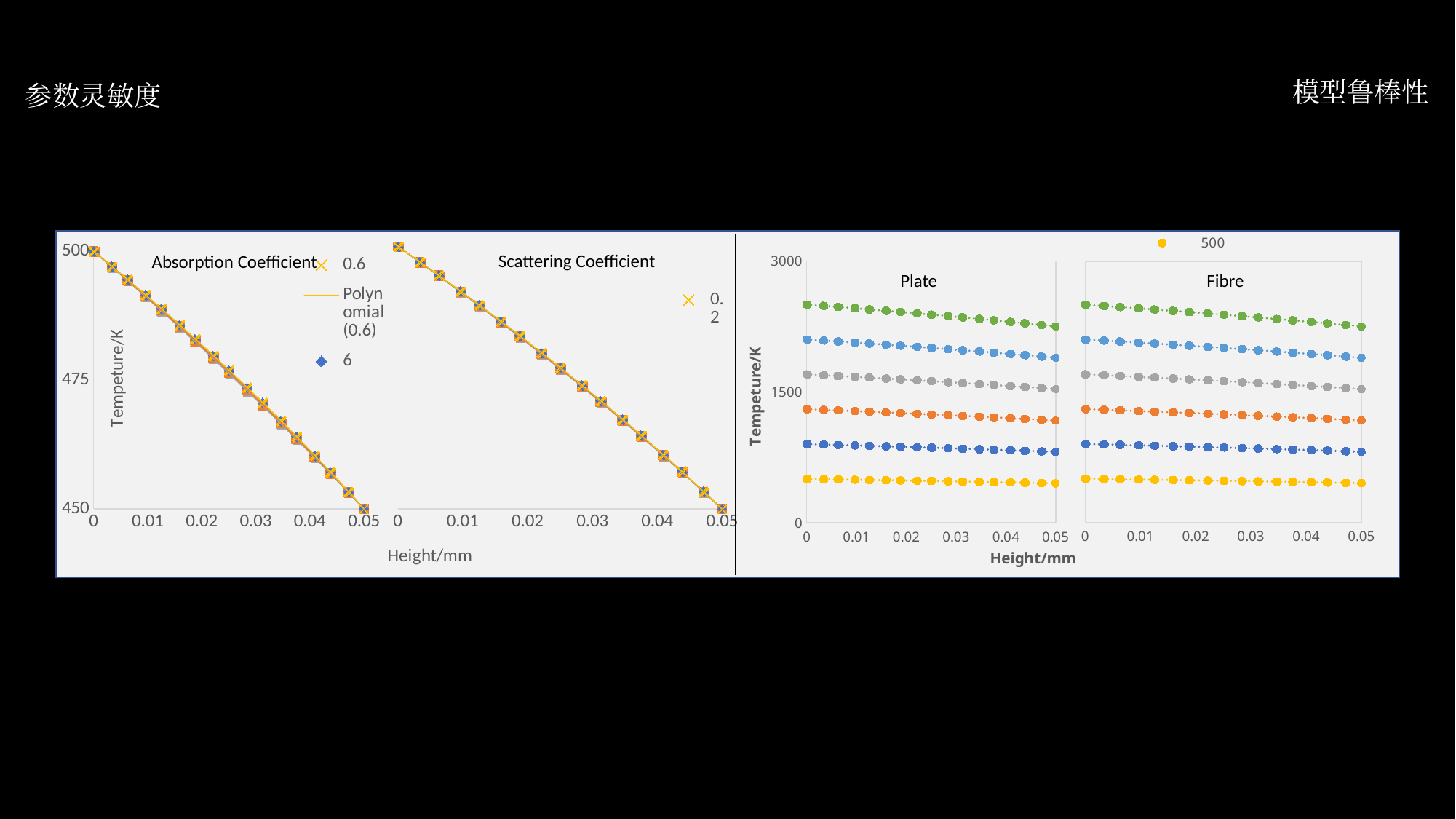
In the Absorption Coefficient chart, is the temperature at Height 0.02 greater or less than 475? greater In the right-hand chart's Plate panel, is the yellow series at Height 0 greater or less than 1500? less What is the legend entry shown for the Scattering Coefficient chart? 0.2 How many panels does the right-hand chart have? 2 In the right-hand chart's Plate panel, is the green series at Height 0 greater or less than 1500? greater What kind of chart is the Absorption Coefficient chart? scatter chart In the right-hand chart's Fibre panel, does the green series rise or fall as Height/mm increases? fall In the Absorption Coefficient chart, do the temperature values rise or fall as Height/mm increases? fall In the Scattering Coefficient chart, do the temperature values rise or fall as Height/mm increases? fall What is the x-axis label of the Absorption Coefficient chart? Height/mm How many entries does the legend of the Absorption Coefficient chart list? 3